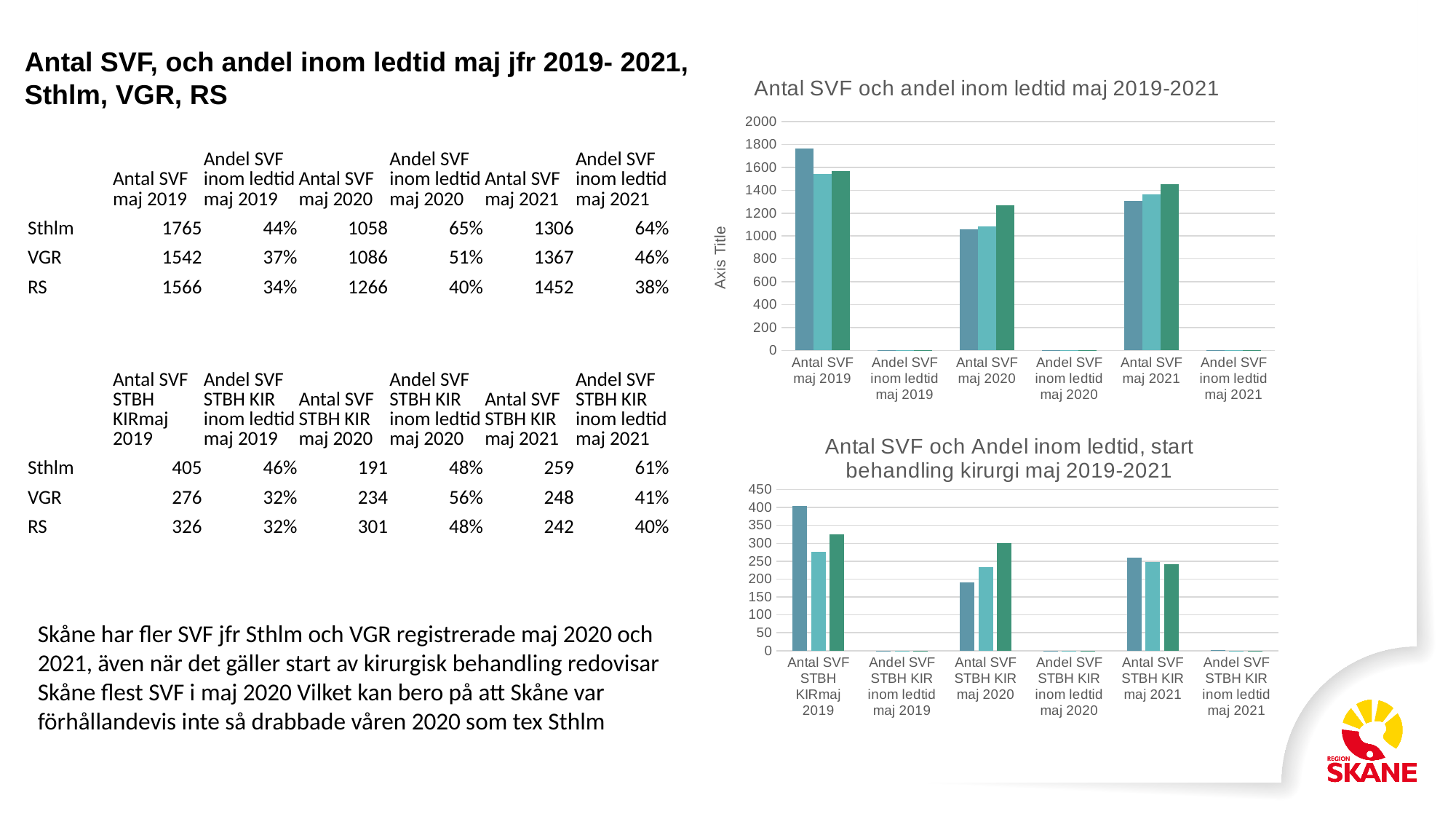
What kind of chart is the top chart titled 'Antal SVF och andel inom ledtid maj 2019-2021'? bar chart How many categories are shown on the x axis of the top chart 'Antal SVF och andel inom ledtid maj 2019-2021'? 6 In the bottom chart 'Antal SVF och Andel inom ledtid, start behandling kirurgi maj 2019-2021', which category group contains the tallest bar? Antal SVF STBH KIRmaj 2019 In the top chart 'Antal SVF och andel inom ledtid maj 2019-2021', is the tallest bar in the 'Antal SVF maj 2019' group greater or less than 1600? greater In the bottom chart 'Antal SVF och Andel inom ledtid, start behandling kirurgi maj 2019-2021', is the shortest bar in the 'Antal SVF STBH KIR maj 2020' group greater or less than 250? less How many categories are shown on the x axis of the bottom chart 'Antal SVF och Andel inom ledtid, start behandling kirurgi maj 2019-2021'? 6 In the top chart 'Antal SVF och andel inom ledtid maj 2019-2021', which category group contains the tallest bar? Antal SVF maj 2019 In the top chart 'Antal SVF och andel inom ledtid maj 2019-2021', is the shortest bar in the 'Antal SVF maj 2020' group greater or less than 1200? less What is the y-axis title shown on the top chart 'Antal SVF och andel inom ledtid maj 2019-2021'? Axis Title In the top chart 'Antal SVF och andel inom ledtid maj 2019-2021', is the tallest bar in 'Antal SVF maj 2019' or the tallest bar in 'Antal SVF maj 2020' larger? Antal SVF maj 2019 What is the title of the bottom chart on the slide? Antal SVF och Andel inom ledtid, start behandling kirurgi maj 2019-2021